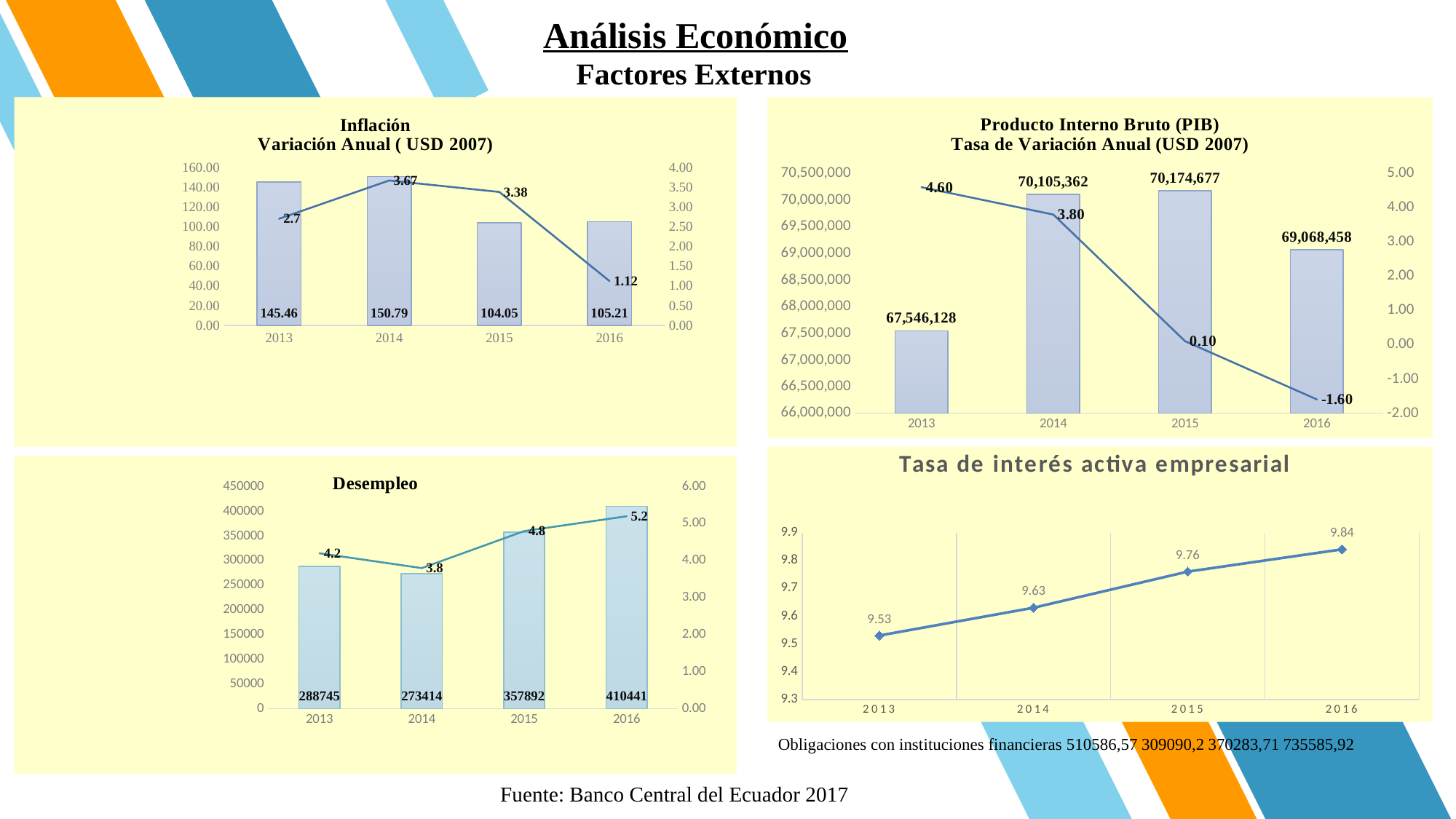
In the Desempleo chart, what is the bar value for 2016? 410441 In the Inflación chart, which year has the lowest bar value? 2015 In the Inflación chart, what is the line value for 2016? 1.12 In the Tasa de interés activa empresarial chart, do the values rise or fall from 2013 to 2016? rise In the Tasa de interés activa empresarial chart, what is the value for 2014? 9.63 In the Inflación chart, what is the bar value for 2014? 150.79 In the Desempleo chart, what is the difference between the bar values for 2016 and 2015? 52549 In the Desempleo chart, which year has the highest bar value? 2016 In the Producto Interno Bruto (PIB) chart, what is the bar value for 2015? 70,174,677 In the Producto Interno Bruto (PIB) chart, what is the line value for 2016? -1.60 In the Producto Interno Bruto (PIB) chart, does the line rise or fall from 2013 to 2016? fall How many years are plotted in the Tasa de interés activa empresarial chart? 4